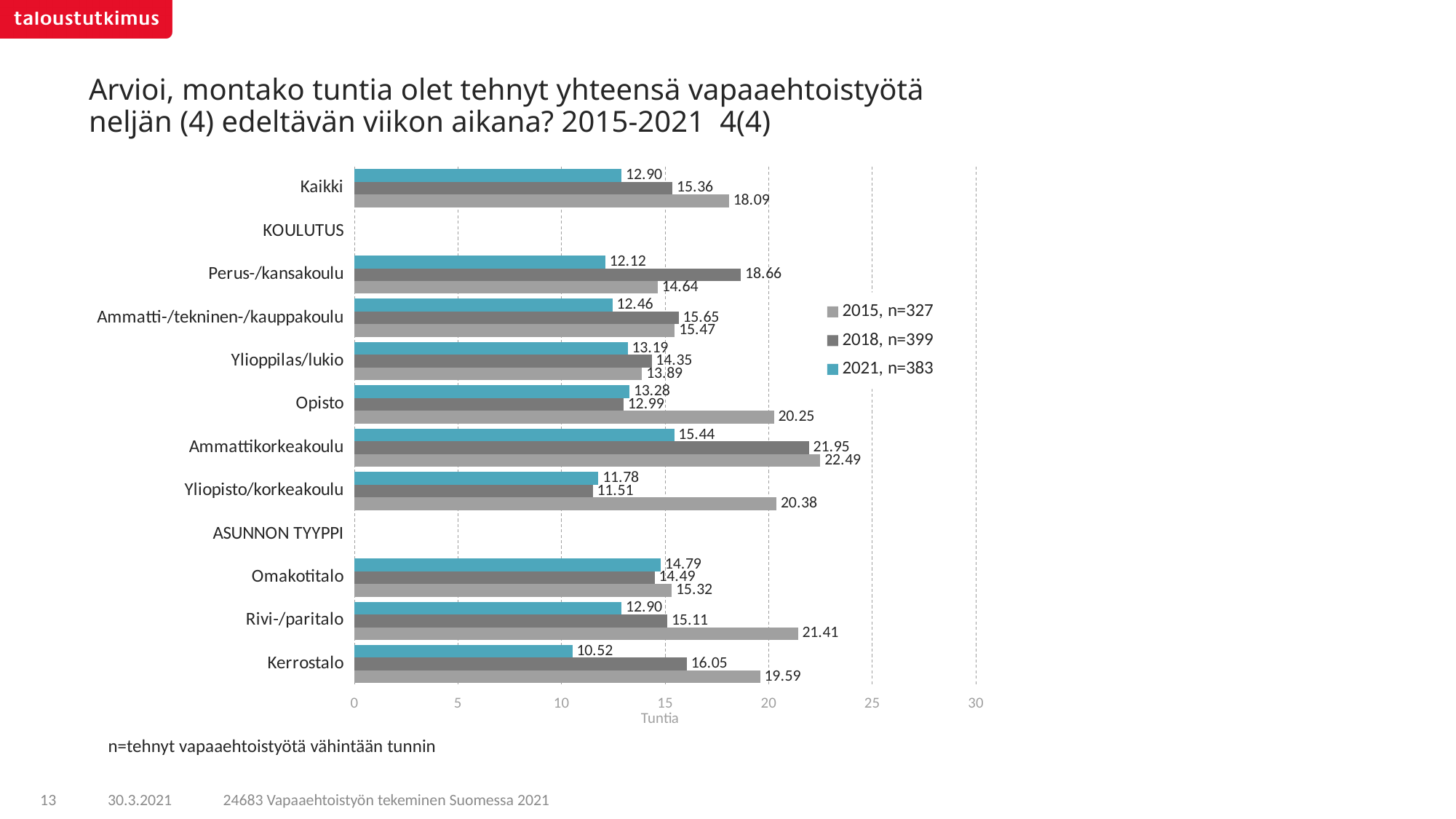
What is the 2021 value for Kaikki? 12.90 What is the difference between the 2015 and 2021 values for Kerrostalo? 9.07 What is the 2018 value for Kerrostalo? 16.05 Which is larger for Perus-/kansakoulu: the 2018 value or the 2015 value? 2018 Which category has the lowest 2015 value? Ylioppilas/lukio What is the 2015 value for Ammattikorkeakoulu? 22.49 What is the difference between the 2015 and 2021 values for Kaikki? 5.19 How many series does the legend list? 3 Which category has the lowest 2021 value? Kerrostalo What kind of chart is shown on the slide? Bar chart Which category has the highest 2021 value? Ammattikorkeakoulu What is the sample size (n) for the 2018 series in the legend? 399